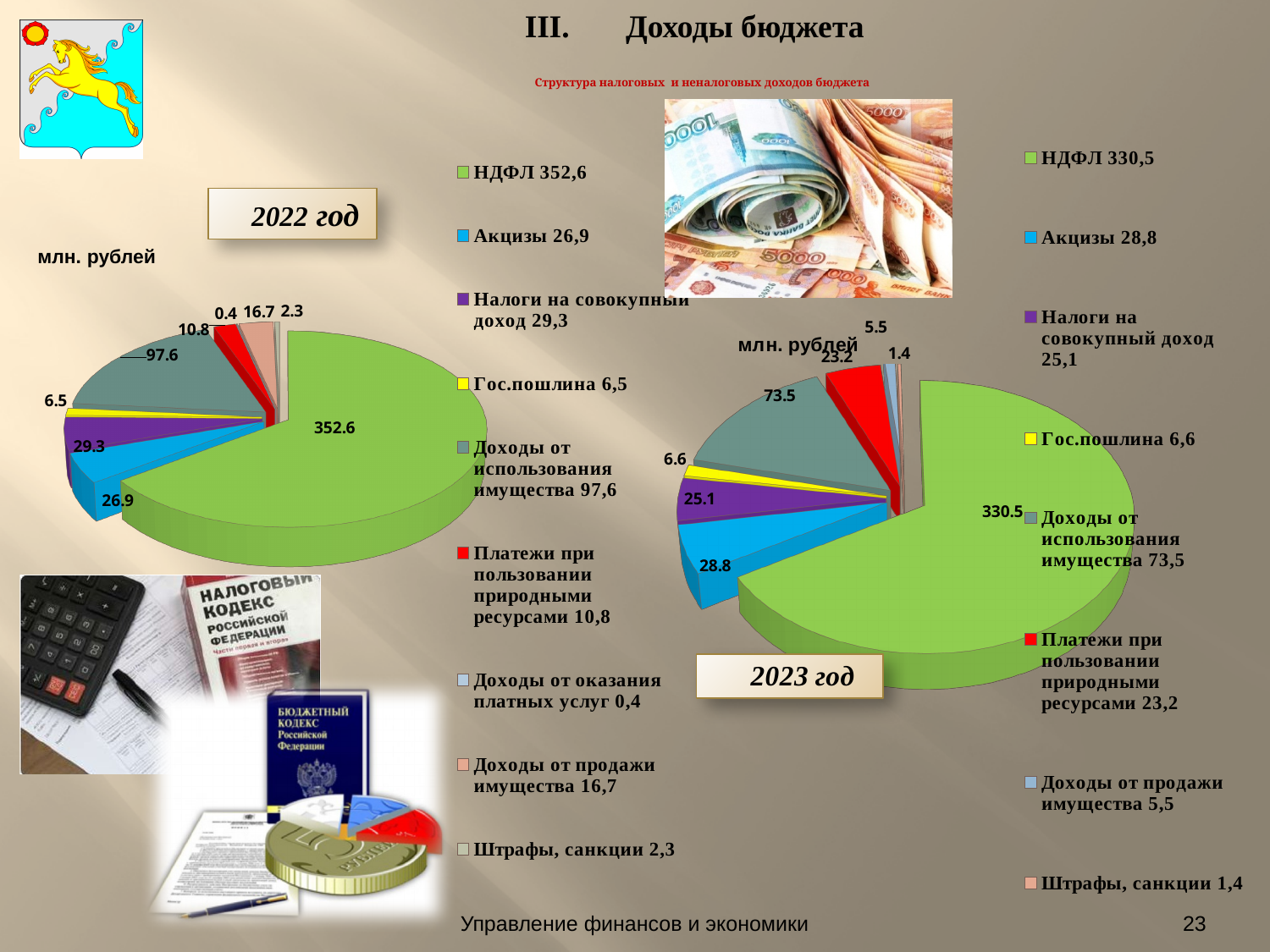
What is the difference between the НДФЛ value in the 2022 год chart and the НДФЛ value in the 2023 год chart? 22.1 In the 2023 год chart, what is the value for Доходы от использования имущества? 73.5 In the 2022 год chart, what is the difference between Доходы от использования имущества and Акцизы? 70.7 In the 2022 год chart, what is the value for Акцизы? 26.9 What type of chart is used for the 2022 год chart? pie chart In the 2022 год chart, which category has the smallest value? Доходы от оказания платных услуг In the 2022 год chart, which category has the largest value? НДФЛ How many categories does the 2023 год chart show? 8 In the 2023 год chart, which category has the smallest value? Штрафы, санкции In the 2023 год chart, what is the value for Платежи при пользовании природными ресурсами? 23.2 In the 2023 год chart, which is larger: Акцизы or Налоги на совокупный доход? Акцизы In the 2022 год chart, what is the value for НДФЛ? 352.6